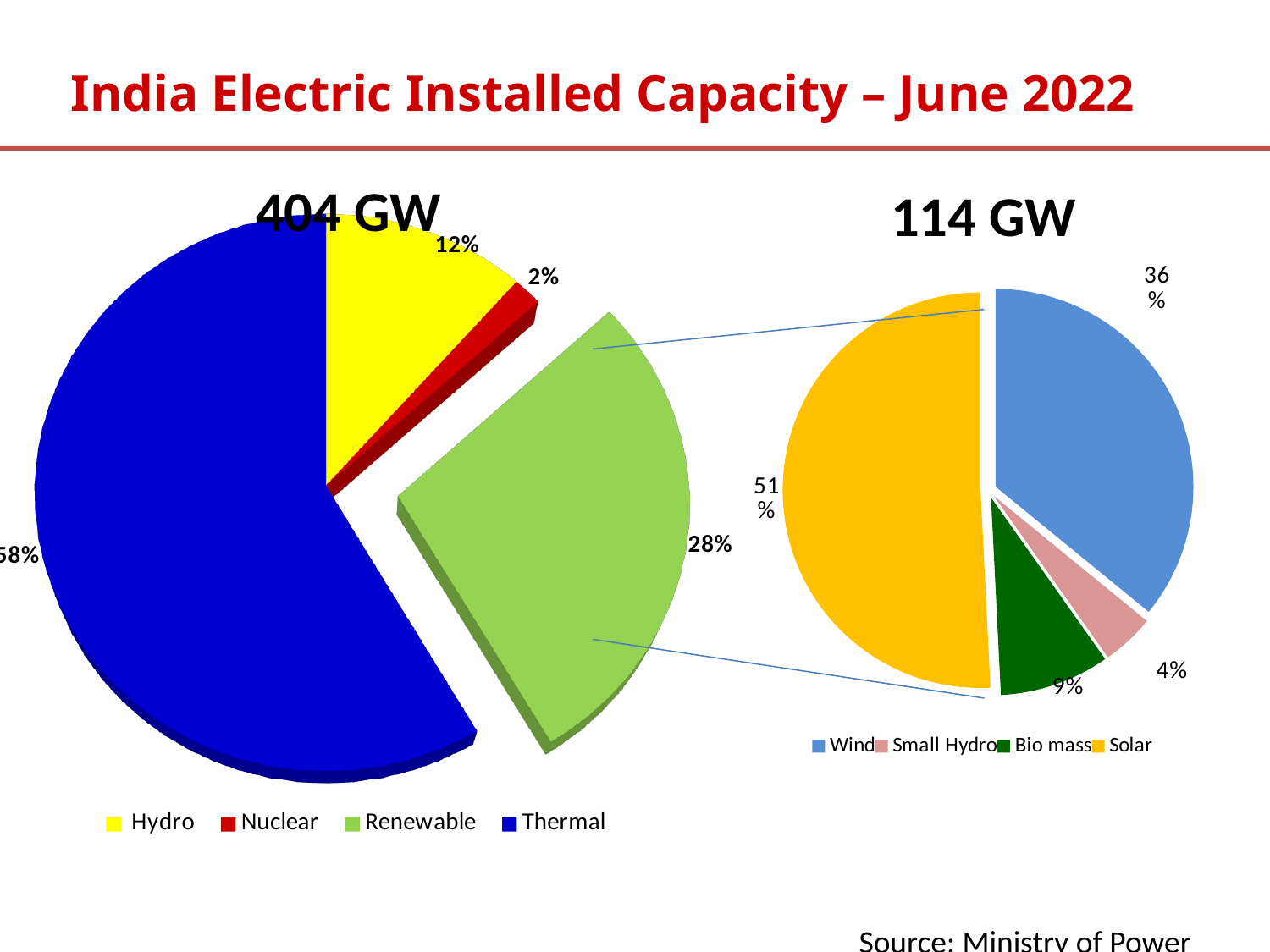
In the 114 GW pie chart, what share does Solar have? 51% How many categories does the legend of the 404 GW pie chart list? 4 In the 114 GW pie chart, which category has the smallest share? Small Hydro In the 114 GW pie chart, what share does Wind have? 36% In the 404 GW pie chart, what share does Renewable have? 28% What kind of chart is the 404 GW chart on the left? Pie chart In the 404 GW pie chart, what share does Hydro have? 12% In the 404 GW pie chart, which category has the largest share? Thermal In the 404 GW pie chart, how many percentage points larger is Renewable than Hydro? 16 In the 404 GW pie chart, which category has the smallest share? Nuclear In the 404 GW pie chart, what share does Nuclear have? 2% In the 114 GW pie chart, which is larger, Bio mass or Small Hydro? Bio mass